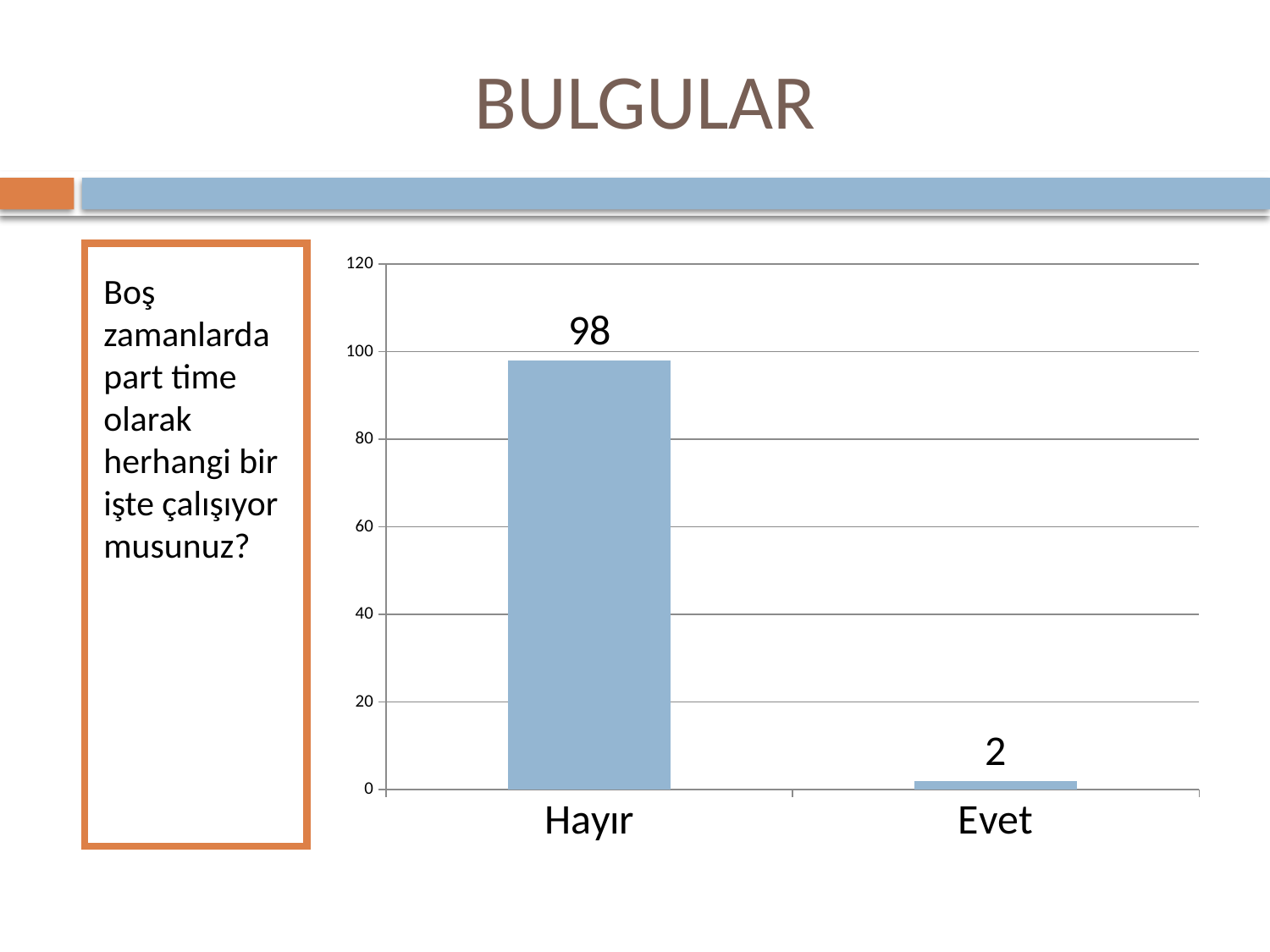
What is the value for Hayır? 98 How many categories are shown on the x axis? 2 Which is larger, the value for Hayır or the value for Evet? Hayır What is the value for Evet? 2 Is the value for Hayır greater or less than 80? greater Which category has the lowest value? Evet What is the difference between the values for Hayır and Evet? 96 Which category has the highest value? Hayır What is the total of the two values shown in the chart? 100 What is the highest value shown on the y axis? 120 Is the value for Evet greater or less than 20? less What kind of chart is shown on the slide? bar chart